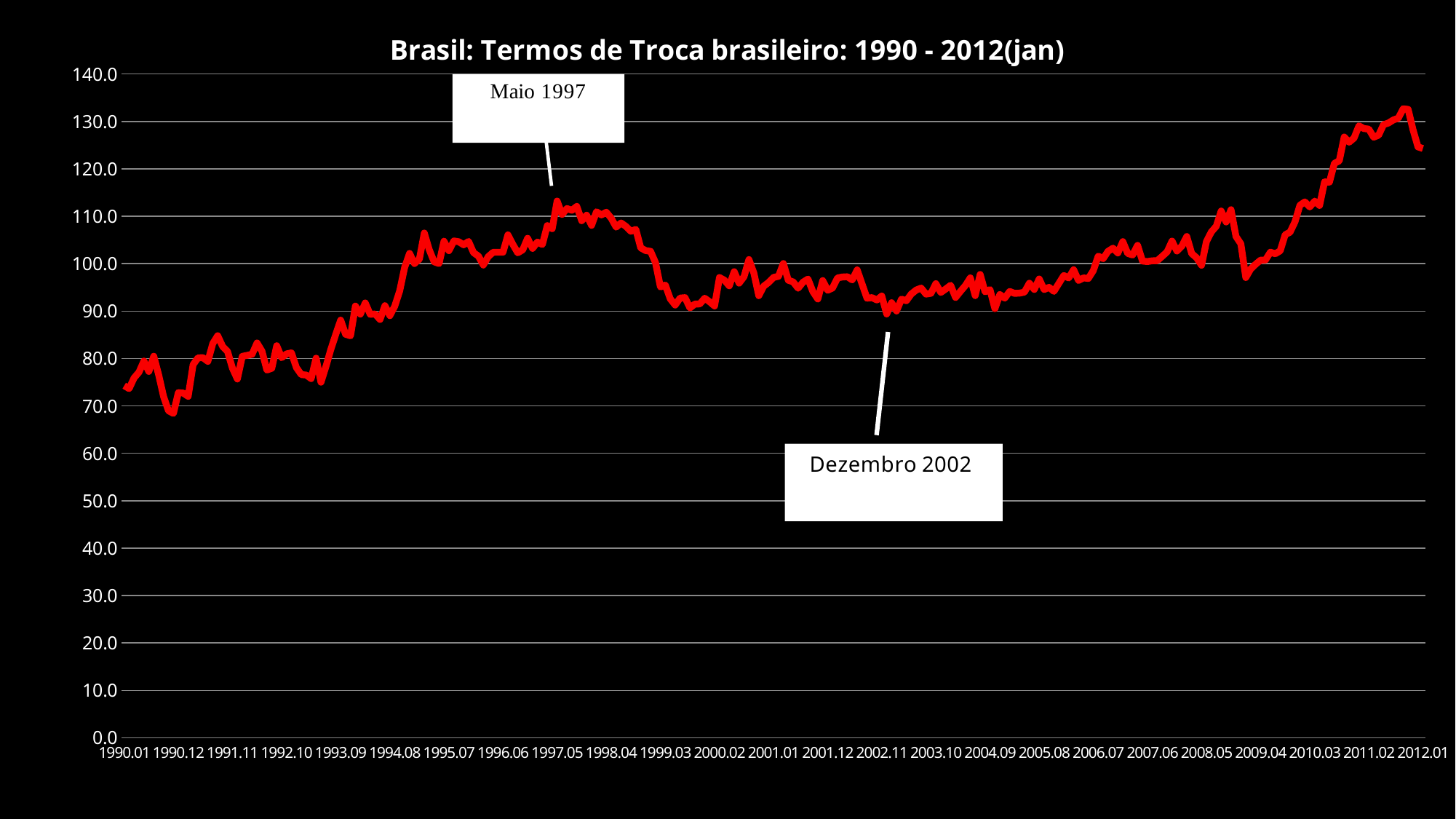
Is the value at 1990.01 greater or less than 80.0? less Which is larger, the value at 1990.01 or the value at 2012.01? 2012.01 Is the value at the point annotated 'Dezembro 2002' greater or less than 100.0? less Does the line generally rise or fall between Dezembro 2002 and 2011.02? rise Which annotated point has the higher value, Maio 1997 or Dezembro 2002? Maio 1997 Does the line generally rise or fall between Maio 1997 and Dezembro 2002? fall Is the value at 2012.01 greater or less than 120.0? greater Which two dates are called out with annotation boxes on the chart? Maio 1997 and Dezembro 2002 What is the title of the chart? Brasil: Termos de Troca brasileiro: 1990 - 2012(jan) What kind of chart is shown on the slide? line chart How many lines (series) are plotted on the chart? 1